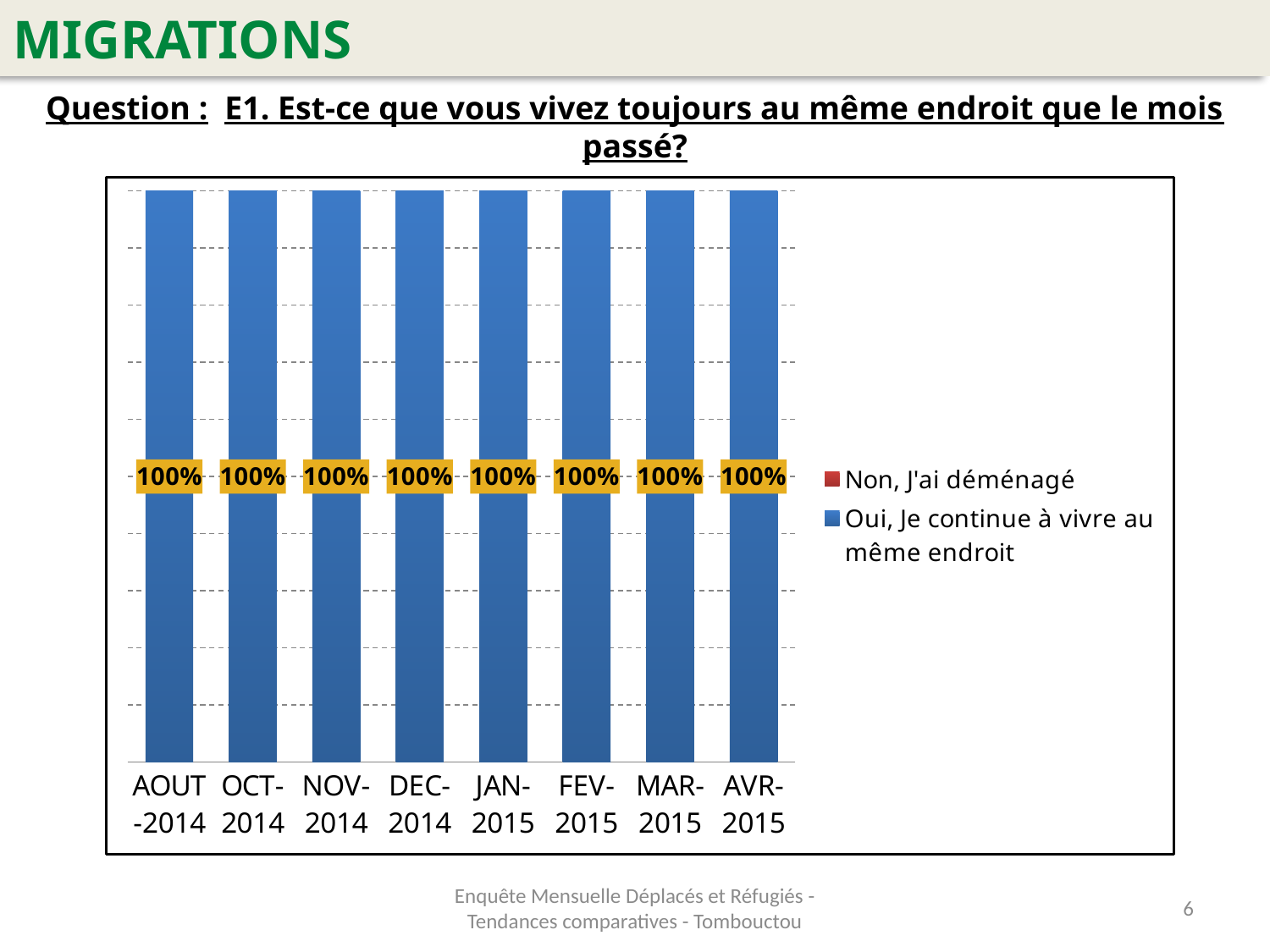
Which legend entry is shown in red? Non, J'ai déménagé What is the first month shown on the x axis? AOUT-2014 What is the value for "Oui, Je continue à vivre au même endroit" in AVR-2015? 100% Which legend entry is shown in blue? Oui, Je continue à vivre au même endroit Do the values rise, fall, or stay the same from AOUT-2014 to AVR-2015? stay the same What is the value for "Oui, Je continue à vivre au même endroit" in JAN-2015? 100% What is the value for "Oui, Je continue à vivre au même endroit" in AOUT-2014? 100% How many series does the legend list? 2 What type of chart is shown on the slide? bar chart What is the last month shown on the x axis? AVR-2015 How many months (categories) are shown on the x axis of the chart? 8 What is the difference between the values for DEC-2014 and MAR-2015? 0%